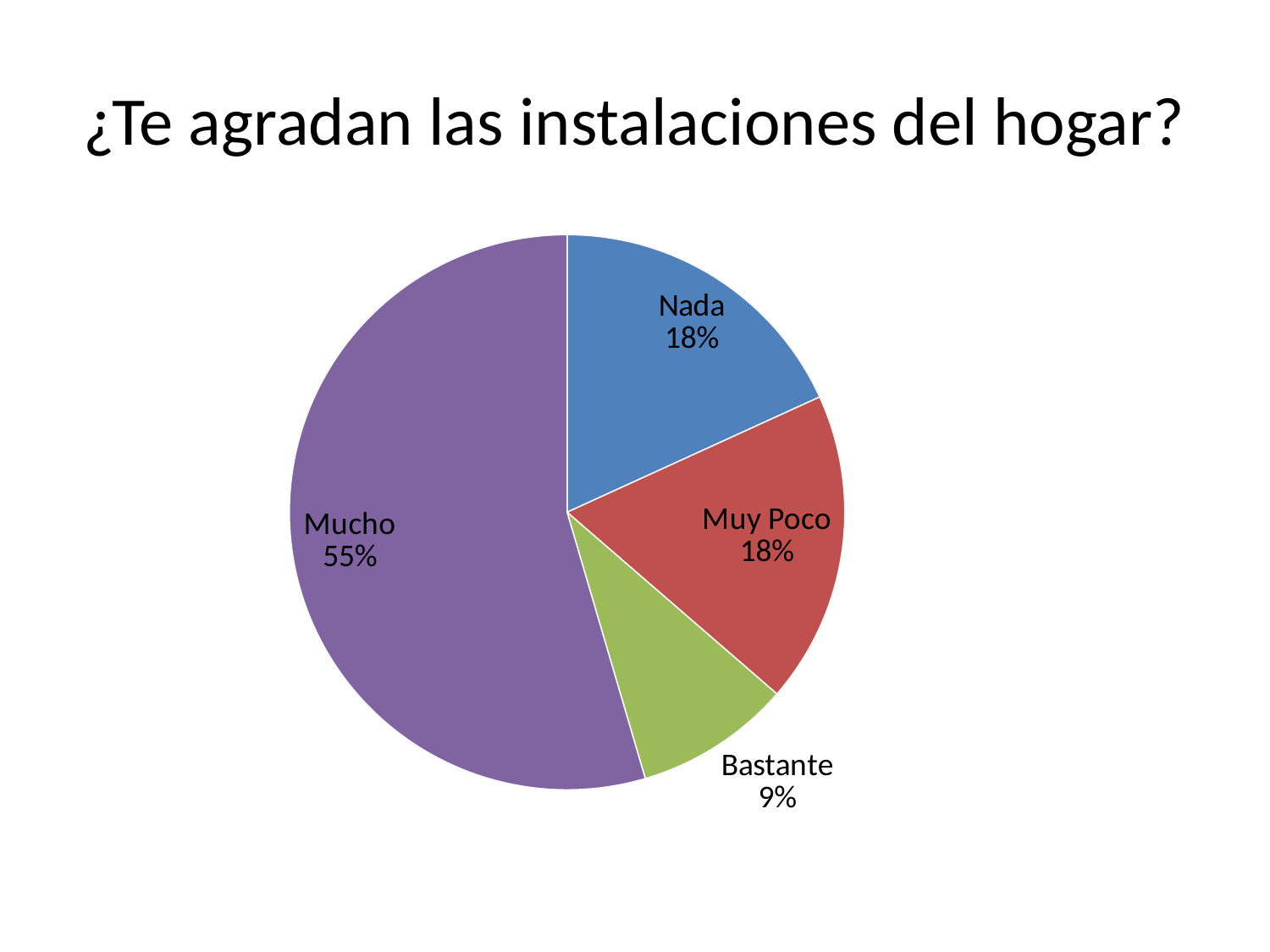
How many slices does the pie chart have? 4 What percentage of responses is 'Muy Poco'? 18% What colour is the 'Mucho' slice? purple Which category has the largest share of the pie? Mucho What percentage of responses is 'Mucho'? 55% What kind of chart is shown on the slide? pie chart What is the title of the chart? ¿Te agradan las instalaciones del hogar? What percentage of responses is 'Bastante'? 9% What percentage of responses is 'Nada'? 18% What is the difference in percentage points between 'Mucho' and 'Bastante'? 46 Which category has the smallest share of the pie? Bastante Which is larger, the share for 'Nada' or the share for 'Bastante'? Nada